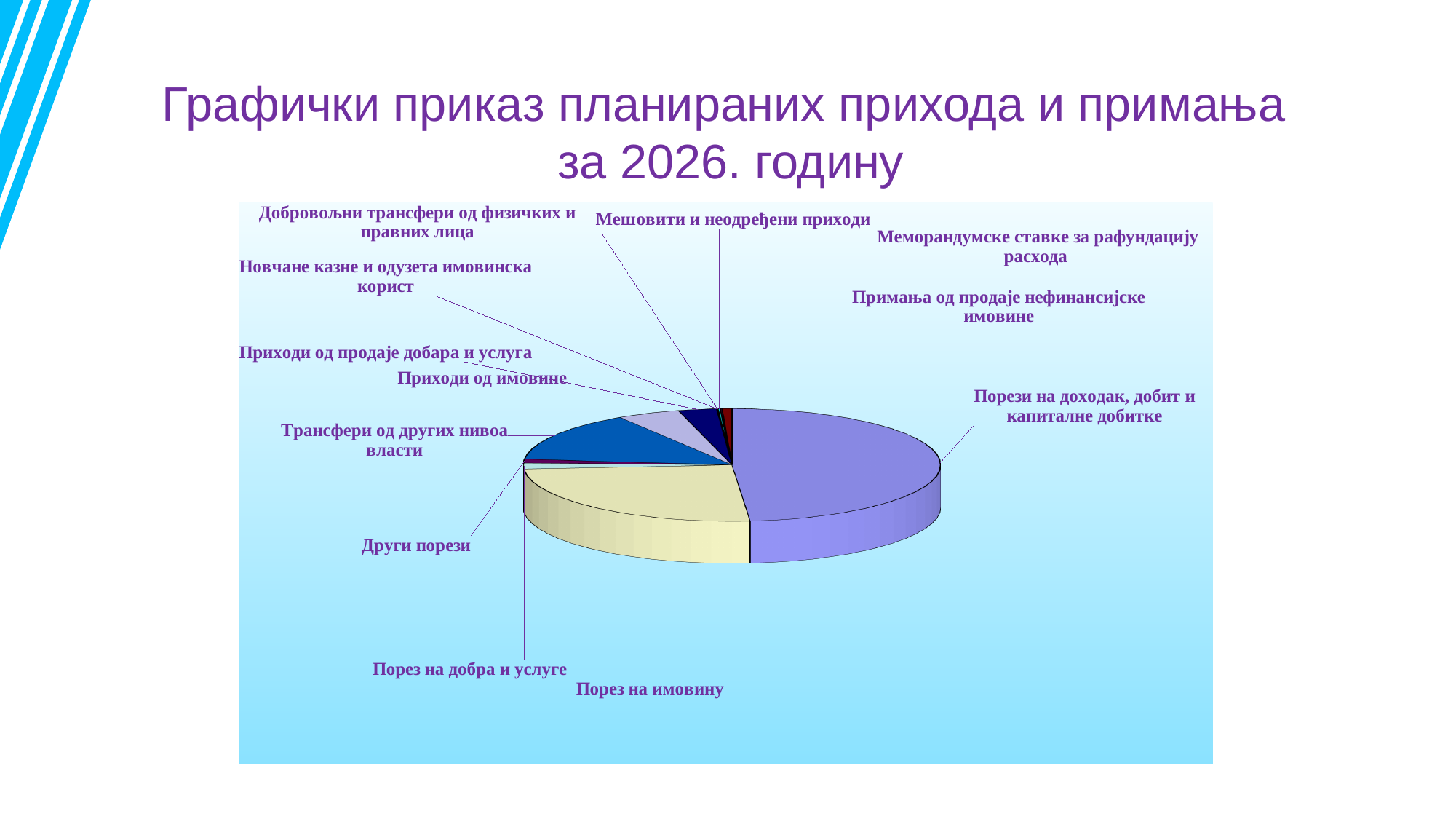
What colour is the largest slice of the pie chart? Light purple Which category has the second largest slice of the pie chart? Порез на имовину How many categories are labelled on the pie chart? 12 Which slice is larger: Порези на доходак, добит и капиталне добитке or Порез на добра и услуге? Порези на доходак, добит и капиталне добитке What kind of chart is shown on the slide? Pie chart Which slice is larger: Трансфери од других нивоа власти or Приходи од имовине? Трансфери од других нивоа власти Which slice is larger: Порез на имовину or Приходи од имовине? Порез на имовину Which category has the largest slice of the pie chart? Порези на доходак, добит и капиталне добитке What is the title of the slide containing the pie chart? Графички приказ планираних прихода и примања за 2026. годину